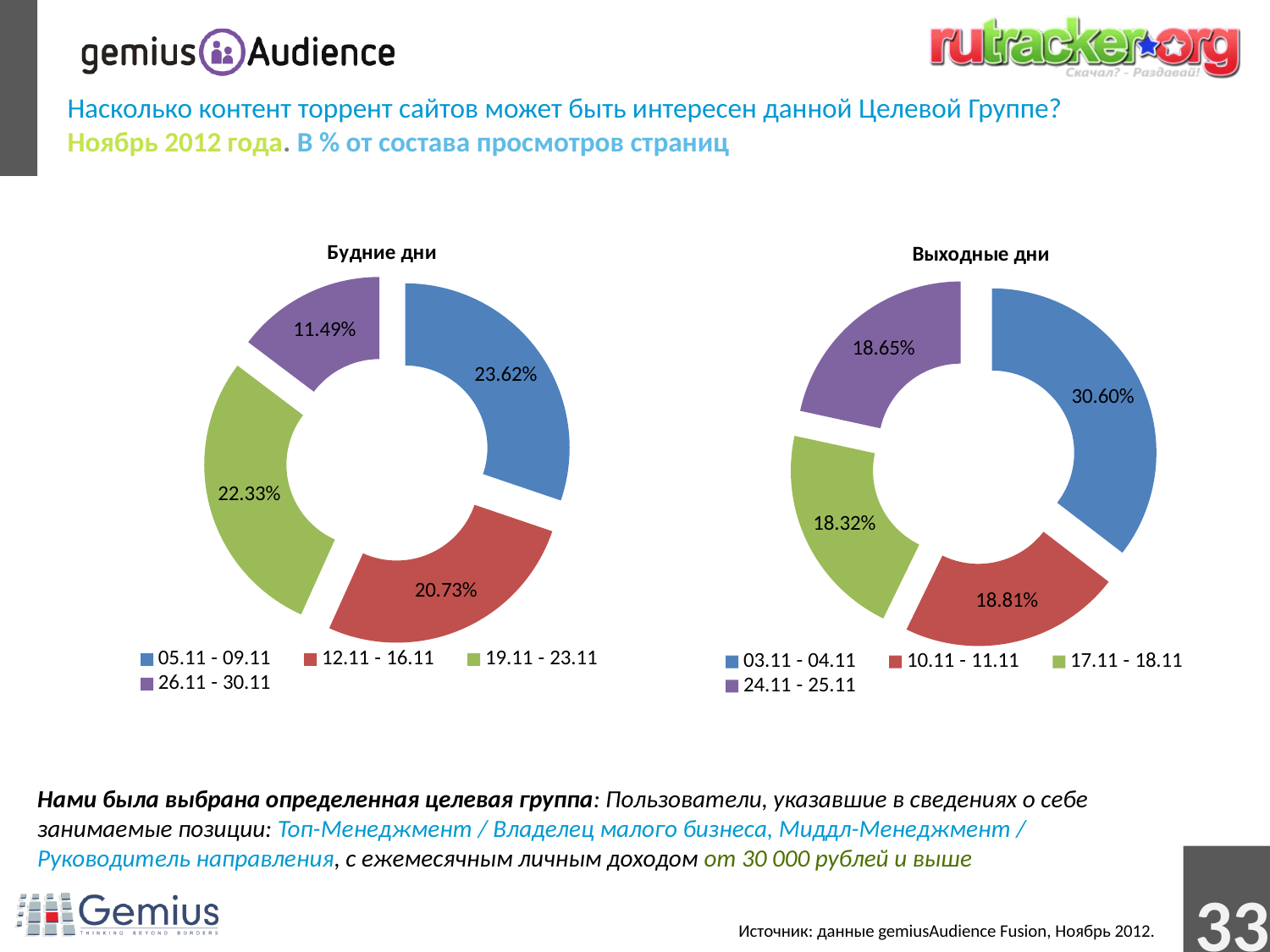
In the "Выходные дни" chart, what is the value for 17.11 - 18.11? 18.32% In the "Выходные дни" chart, what is the value for 03.11 - 04.11? 30.60% In the "Будние дни" chart, which colour represents 12.11 - 16.11? Red In the "Будние дни" chart, which is larger: the value for 12.11 - 16.11 or the value for 19.11 - 23.11? 19.11 - 23.11 What type of chart is the "Будние дни" chart? Doughnut chart In the "Выходные дни" chart, which period has the largest share? 03.11 - 04.11 In the "Выходные дни" chart, what is the difference between the values for 03.11 - 04.11 and 10.11 - 11.11? 11.79% In the "Будние дни" chart, what is the value for 05.11 - 09.11? 23.62% In the "Будние дни" chart, what is the value for 19.11 - 23.11? 22.33% In the "Будние дни" chart, which period has the smallest share? 26.11 - 30.11 In the "Будние дни" chart, what is the difference between the values for 05.11 - 09.11 and 26.11 - 30.11? 12.13% How many segments does the "Выходные дни" chart have? 4